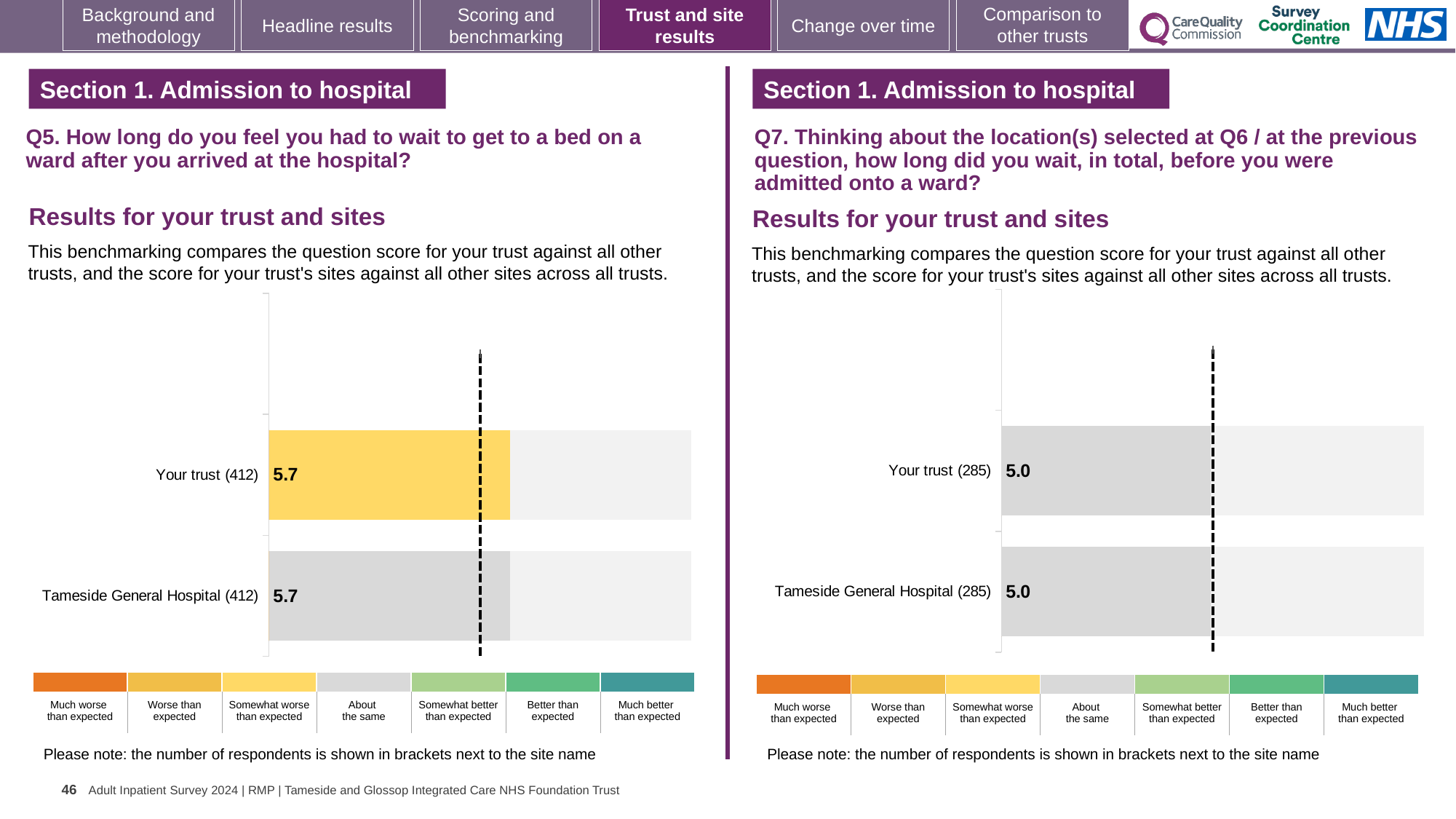
In the Q5 chart on the left, how many respondents are shown in brackets next to Your trust? 412 How many bars are plotted in the Q7 chart on the right? 2 In the Q5 chart on the left, what is the difference between the Your trust score and the Tameside General Hospital score? 0.0 What kind of chart is the Q5 chart on the left? Bar chart In the Q5 chart on the left, which benchmark category does the colour of the Your trust bar correspond to in the key? Somewhat worse than expected In the Q5 chart on the left, what is the score for Tameside General Hospital? 5.7 In the Q7 chart on the right, how many respondents are shown in brackets next to Tameside General Hospital? 285 In the Q7 chart on the right, what is the score for Tameside General Hospital? 5.0 In the Q7 chart on the right, what is the score for Your trust? 5.0 In the Q5 chart on the left, what is the score for Your trust? 5.7 In the Q7 chart on the right, what is the difference between the Your trust score and the Tameside General Hospital score? 0.0 How many bars are plotted in the Q5 chart on the left? 2